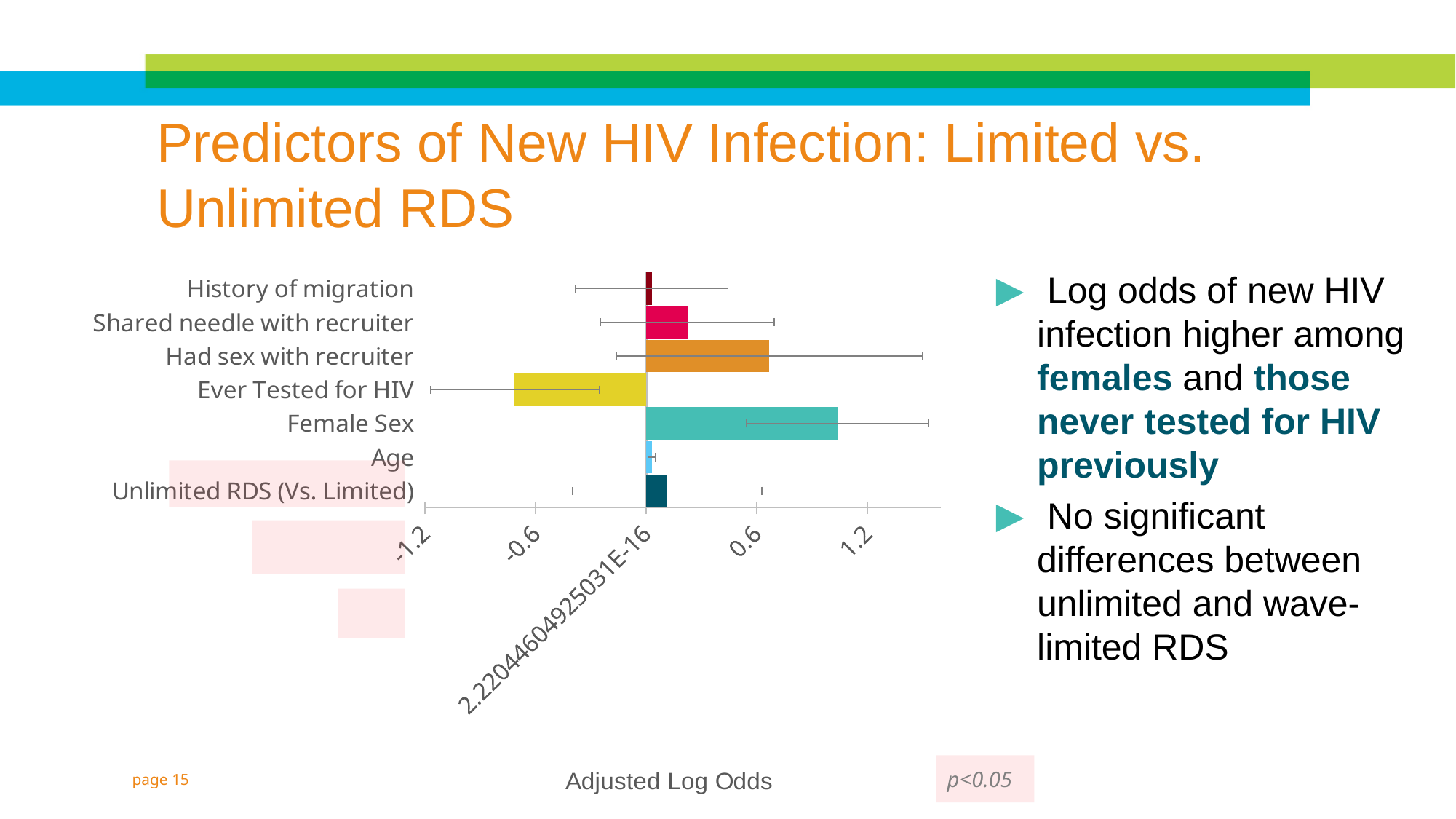
Which predictor has the highest adjusted log odds? Female Sex How many categories (predictors) are plotted in the chart? 7 Which has the larger adjusted log odds, Had sex with recruiter or Shared needle with recruiter? Had sex with recruiter Is the value for Female Sex greater or less than 0.6? greater What is the title of the chart's x axis? Adjusted Log Odds Which predictor has the lowest adjusted log odds? Ever Tested for HIV Is the value for Ever Tested for HIV greater or less than -0.6? less Which predictor is the only one with a negative adjusted log odds? Ever Tested for HIV Is the value for Female Sex greater or less than 1.2? less Which has the larger adjusted log odds, Female Sex or Had sex with recruiter? Female Sex What kind of chart is shown on the slide? bar chart